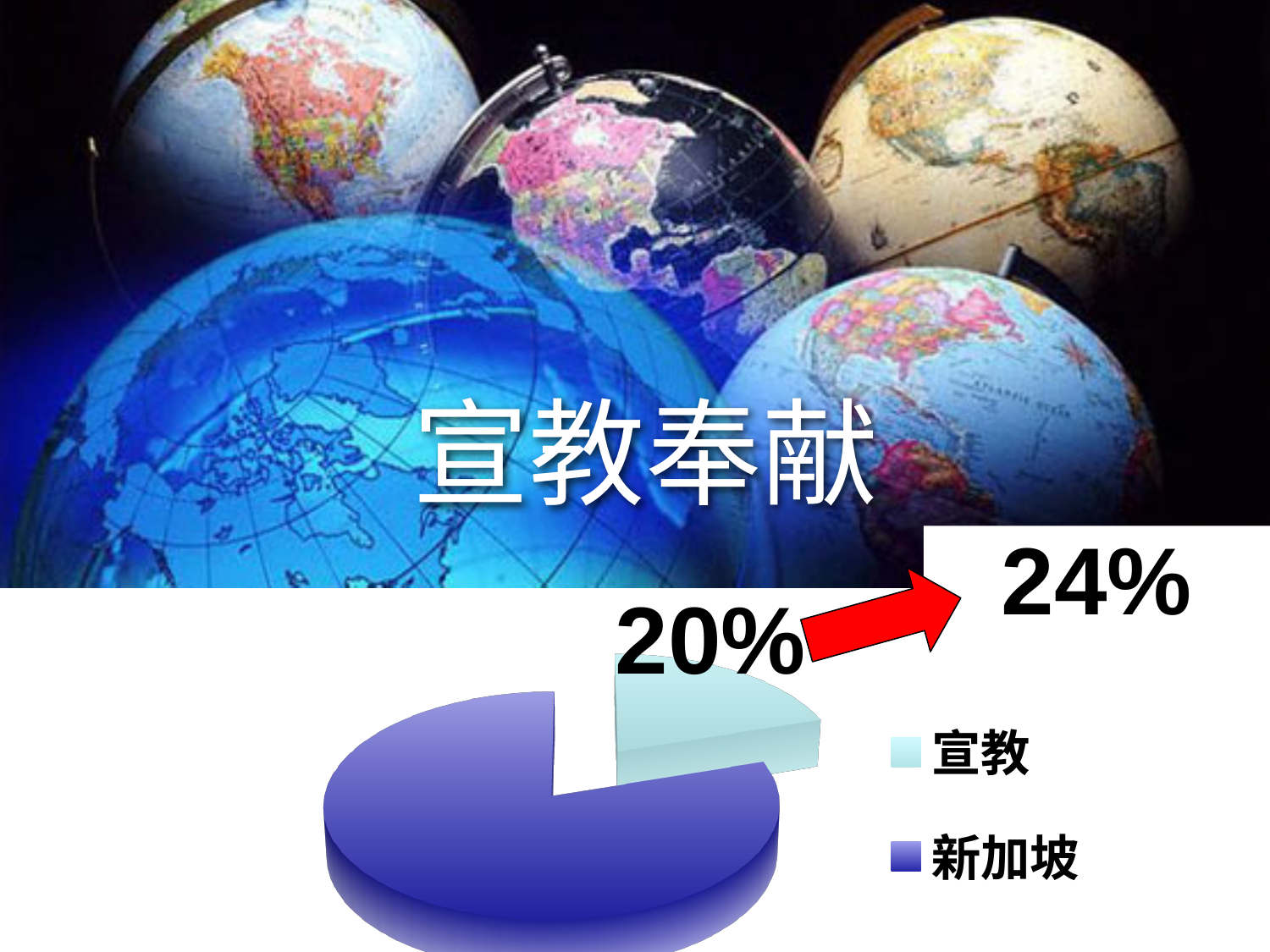
What percentage does the red arrow next to the 20% label point to? 24% Which slice of the pie chart is the smallest? 宣教 What kind of chart is shown on the slide? Pie chart Which is larger in the pie chart, 宣教 or 新加坡? 新加坡 Which slice of the pie chart is the largest? 新加坡 What share of the pie does the 宣教 slice represent? 20% What percentage is labelled on the 宣教 slice of the pie chart? 20% How many entries does the legend list? 2 What is the title of the chart on the slide? 宣教奉獻 How many slices does the pie chart have? 2